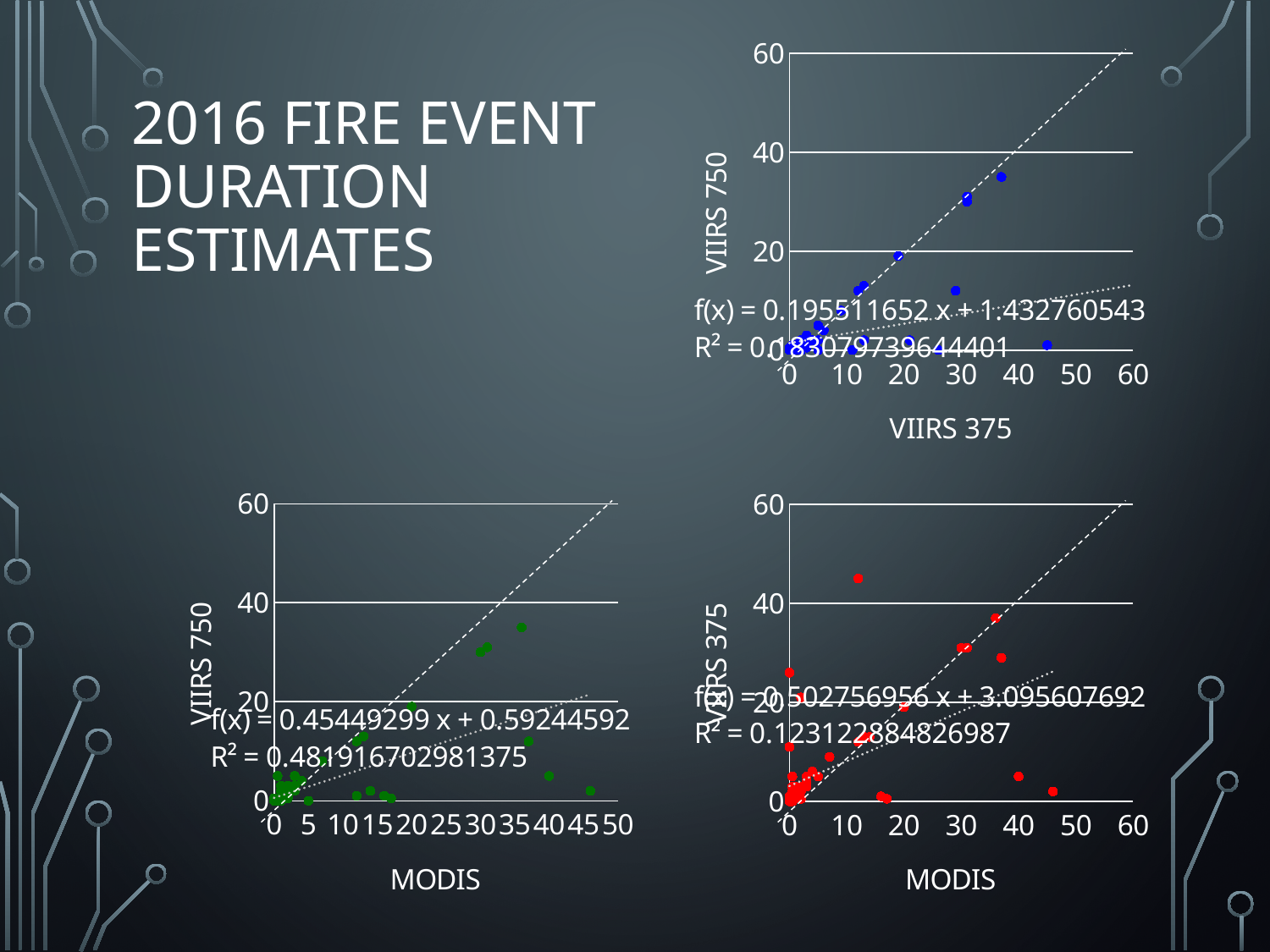
In the bottom-left chart (VIIRS 750 vs MODIS), what is the R² value? 0.481916702981375 In the bottom-left chart (VIIRS 750 vs MODIS), what is the fitted equation f(x)? 0.45449299 x + 0.59244592 In the bottom-right chart (VIIRS 375 vs MODIS), what is the R² value? 0.123122884826987 In the top-right chart (VIIRS 750 vs VIIRS 375), what is the slope of the fitted line f(x)? 0.195511652 Which chart has the larger fitted-line slope, the bottom-left chart (VIIRS 750 vs MODIS) or the bottom-right chart (VIIRS 375 vs MODIS)? bottom-right chart (VIIRS 375 vs MODIS) In the bottom-right chart (VIIRS 375 vs MODIS), is the VIIRS 375 value of the highest point greater or less than 40? greater What kind of chart is the top-right chart with the blue points? scatter chart In the top-right chart (VIIRS 750 vs VIIRS 375), what is the intercept of the fitted line f(x)? 1.432760543 In the top-right chart, what is the label of the x axis? VIIRS 375 How many charts are shown on the slide? 3 In the bottom-right chart (VIIRS 375 vs MODIS), what is the slope of the fitted line f(x)? 0.502756956 In the bottom-left chart, what is the label of the y axis? VIIRS 750